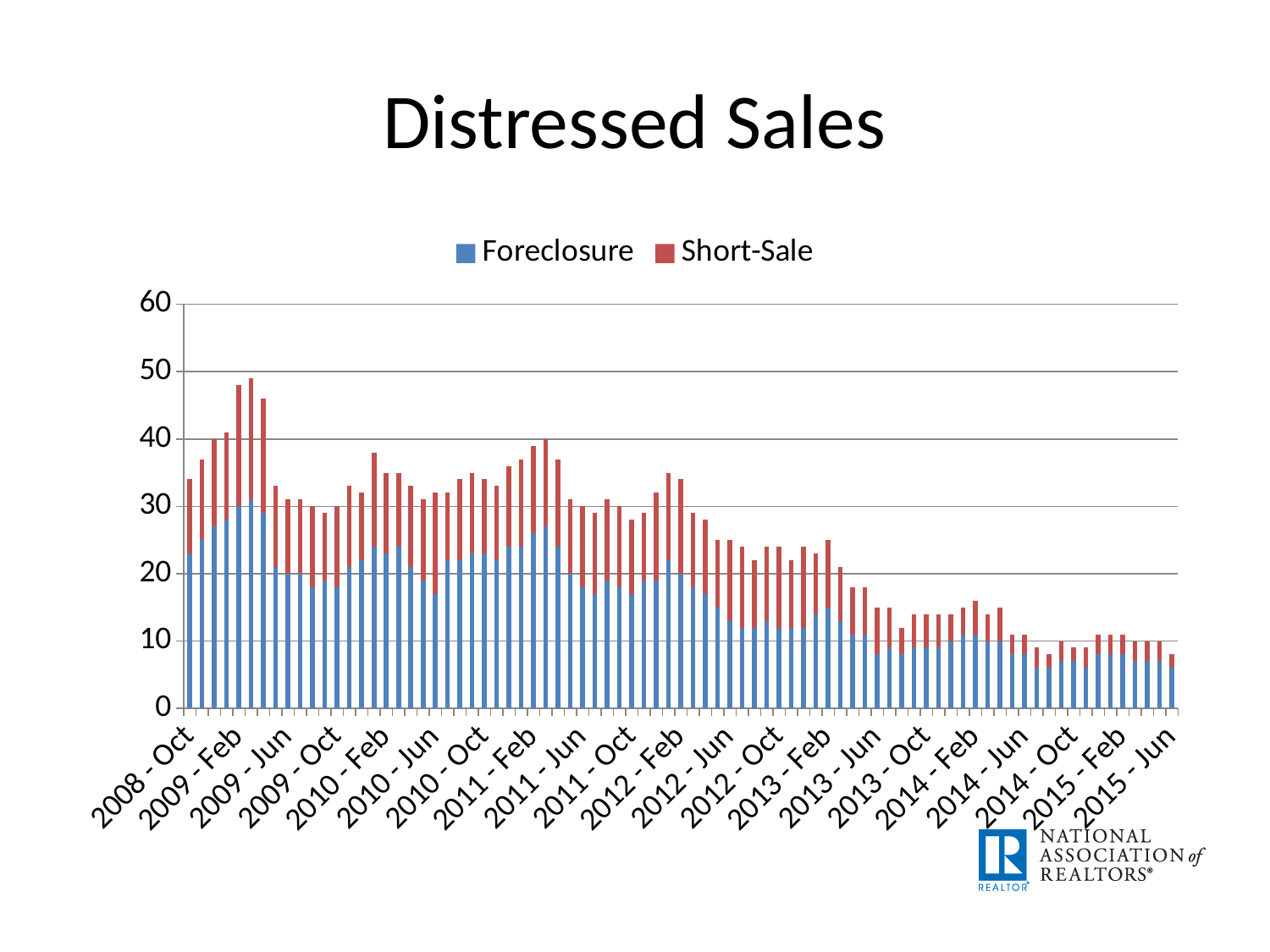
What kind of chart is shown on the slide? Stacked bar chart Is the Foreclosure value for 2015 - Jun greater or less than 10? less Is the total distressed sales value for 2015 - Jun greater or less than 10? less Overall, do total distressed sales rise or fall from 2008 - Oct to 2015 - Jun? fall Which has the larger total distressed sales value, 2009 - Feb or 2013 - Feb? 2009 - Feb What is the title of the chart? Distressed Sales Is the total distressed sales value for 2009 - Feb greater or less than 40? greater In 2008 - Oct, which series has the larger value, Foreclosure or Short-Sale? Foreclosure Which series is shown in red? Short-Sale How many series does the legend list? 2